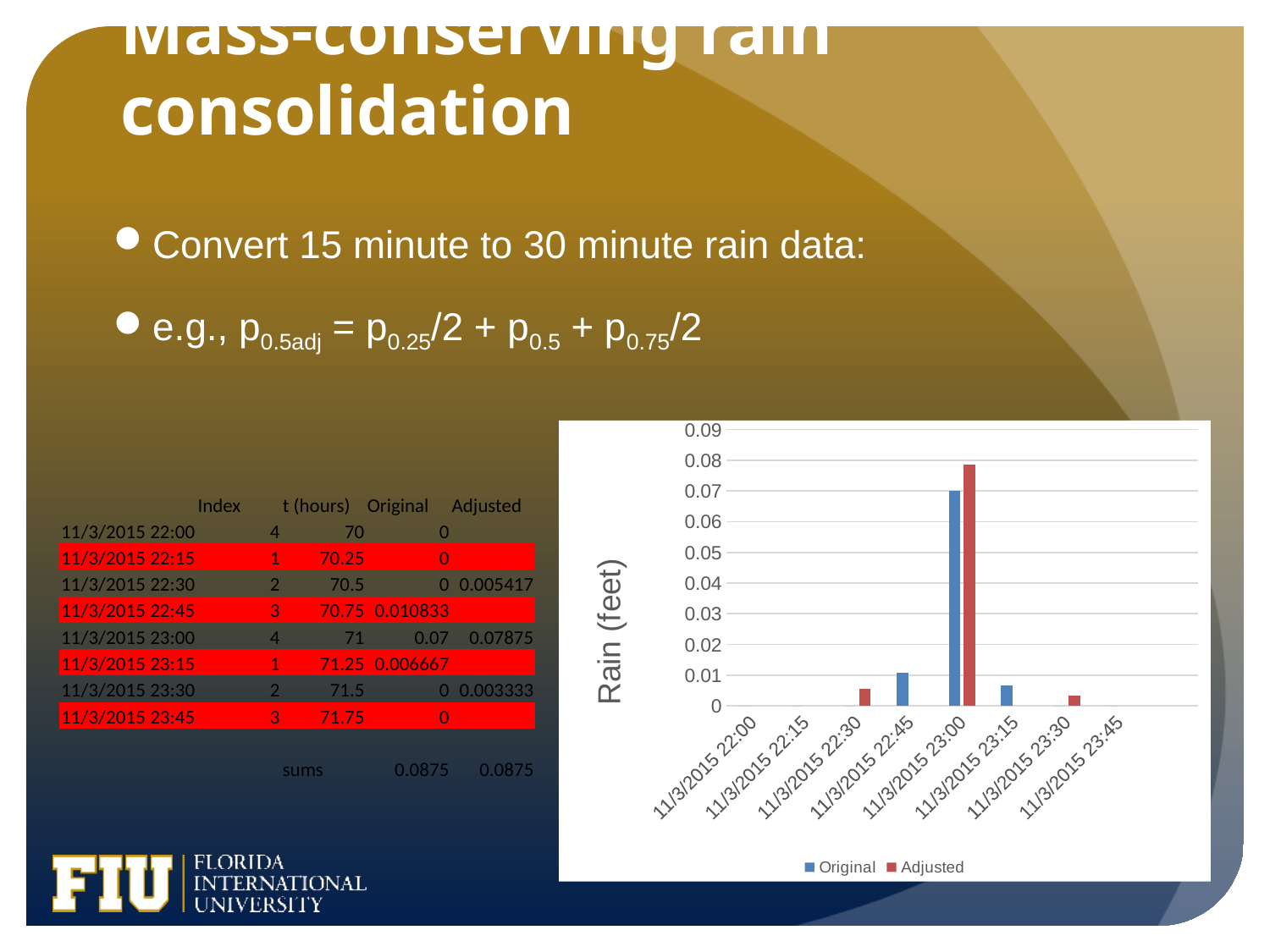
At which time is the Original series highest in the chart? 11/3/2015 23:00 What kind of chart is shown on the slide? bar chart At 11/3/2015 23:00, which is larger, the Original or the Adjusted value? Adjusted Is the Original value at 11/3/2015 22:45 greater or less than 0.02? less At which time is the Adjusted series highest in the chart? 11/3/2015 23:00 How many time categories are shown along the x axis of the chart? 8 How many series does the chart's legend list? 2 At 11/3/2015 22:30, which is larger, the Original or the Adjusted value? Adjusted What is the label on the chart's vertical axis? Rain (feet) What are the two series named in the chart legend? Original and Adjusted Is the Adjusted value at 11/3/2015 23:00 greater or less than 0.07? greater What is the Original value at 11/3/2015 23:00 in the chart? 0.07